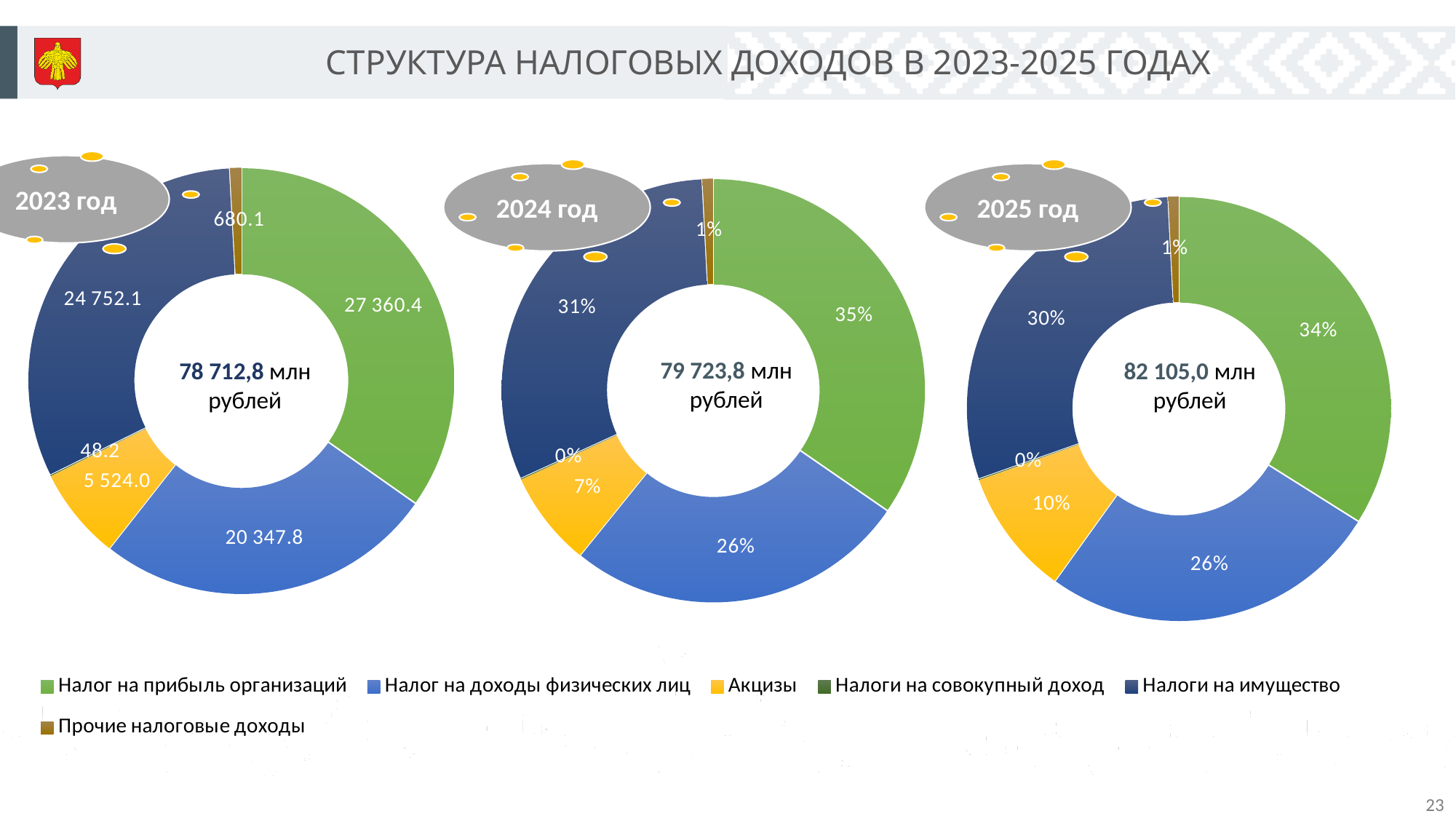
In the 2023 год chart, which category has the largest value? Налог на прибыль организаций In the 2025 год chart, what share is shown for Акцизы? 10% In the 2023 год chart, what is the value for Акцизы? 5 524.0 In the 2023 год chart, what is the value for Налог на прибыль организаций? 27 360.4 In the 2024 год chart, what share is shown for Налоги на имущество? 31% In the 2023 год chart, which category has the smallest value? Налоги на совокупный доход How many series does the legend list? 6 How many pie charts are shown on the slide? 3 In the 2023 год chart, what is the difference between Налог на прибыль организаций and Налоги на имущество? 2 608.3 In the 2025 год chart, which is larger: Налог на прибыль организаций or Налоги на имущество? Налог на прибыль организаций What kind of chart is used to show the structure of tax revenues for each year on this slide? doughnut chart What total is printed in the centre of the 2025 год chart? 82 105,0 млн рублей